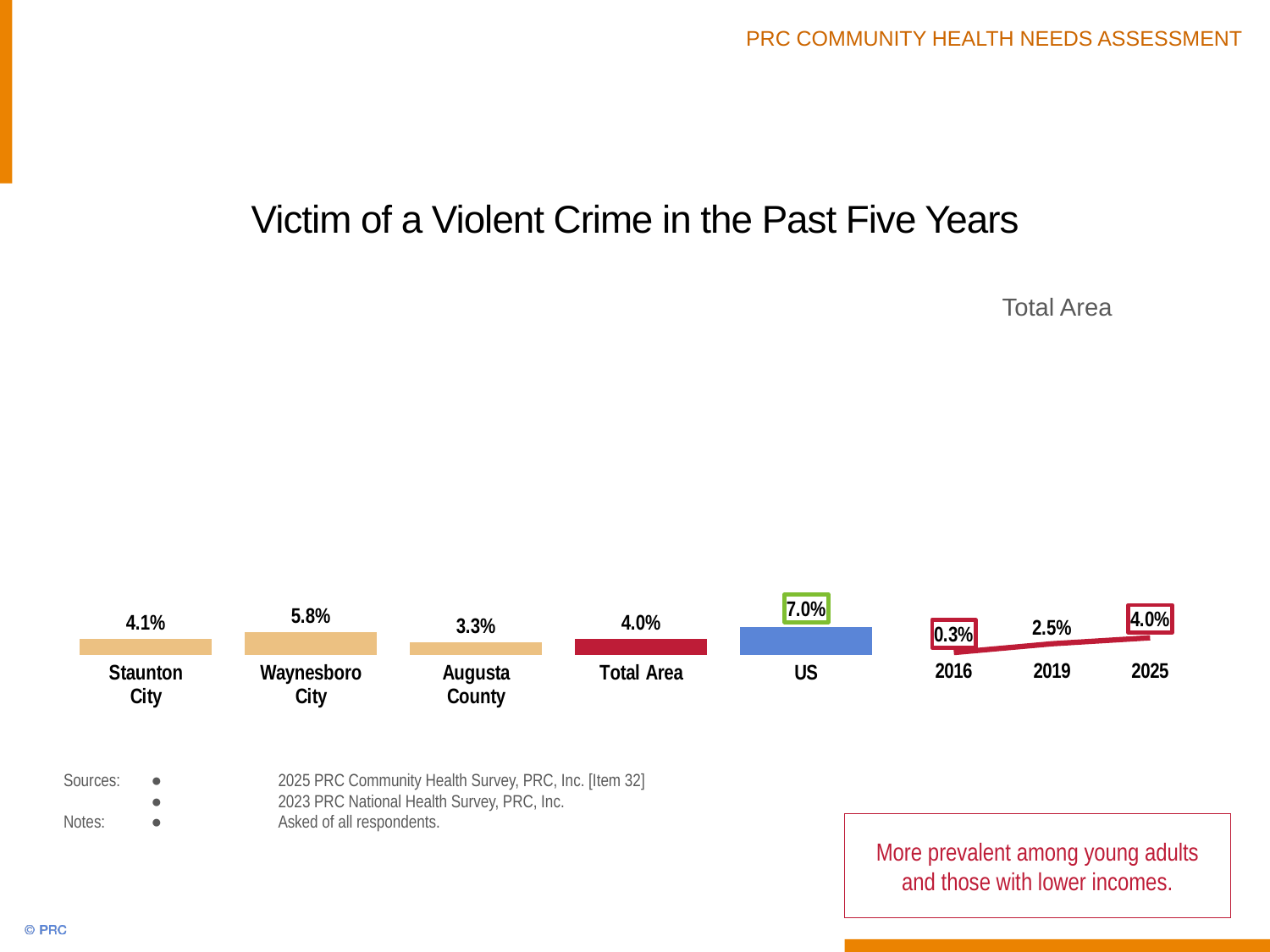
In the bar chart on the left, which is larger, the value for Staunton City or the value for Waynesboro City? Waynesboro City How many categories are shown in the bar chart on the left? 5 In the Total Area trend chart on the right, what is the value for 2016? 0.3% In the bar chart on the left, which category has the highest value? US In the Total Area trend chart on the right, what is the difference between the 2025 value and the 2019 value? 1.5% In the Total Area trend chart on the right, do the values rise or fall from 2016 to 2025? Rise In the bar chart on the left, what is the value for Augusta County? 3.3% In the bar chart on the left, what is the value for the US? 7.0% What kind of chart is the chart on the left showing Staunton City, Waynesboro City, Augusta County, Total Area and US? Bar chart In the bar chart on the left, which category has the lowest value? Augusta County In the bar chart on the left, what is the value for Waynesboro City? 5.8% In the bar chart on the left, what is the difference between the US value and the Total Area value? 3.0%